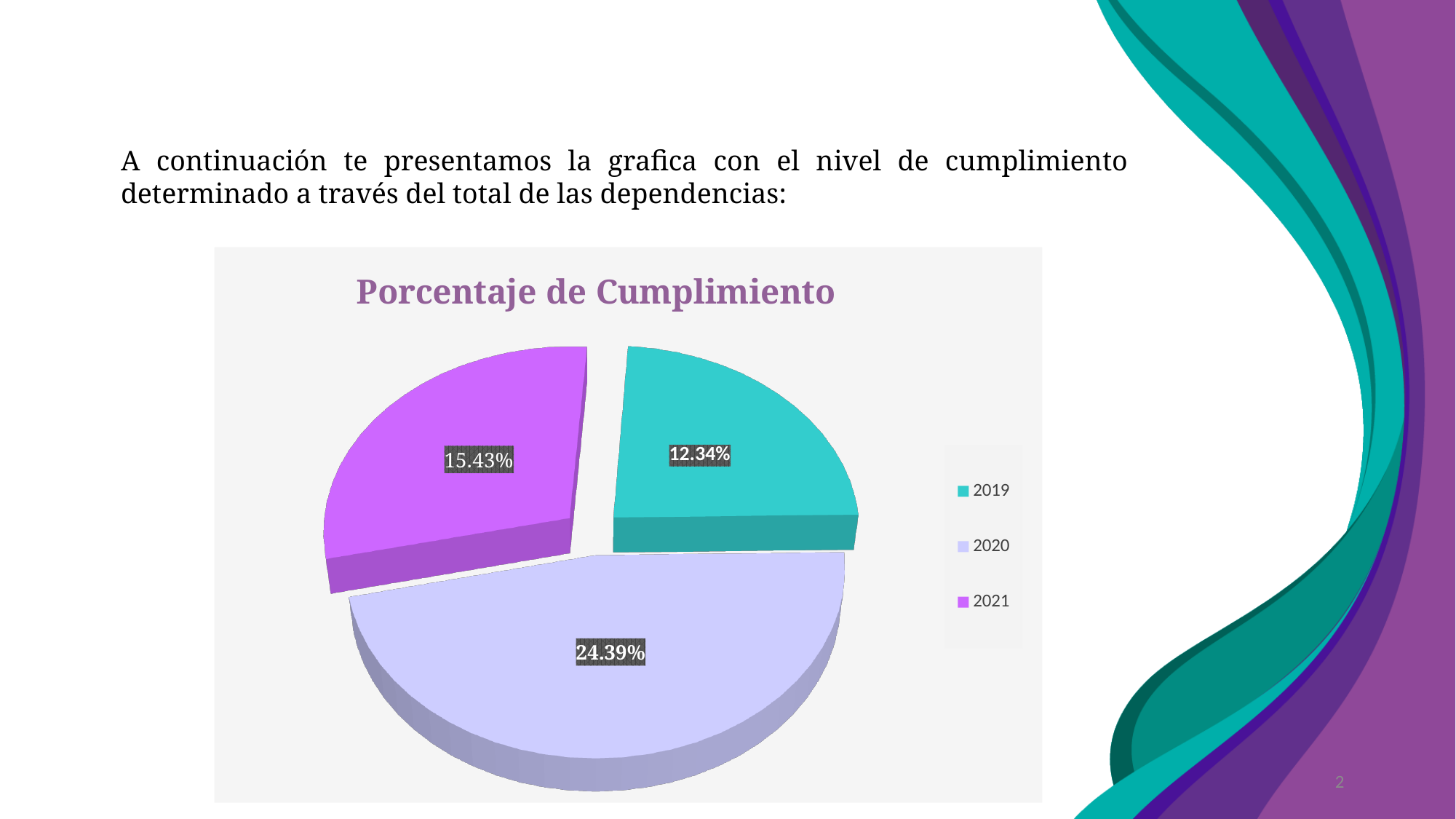
What is the value shown for 2019? 12.34% What is the value shown for 2021? 15.43% What is the value shown for 2020? 24.39% What is the difference between the values for 2021 and 2019? 3.09% What is the difference between the values for 2020 and 2019? 12.05% Which year has the largest slice of the pie? 2020 What is the title of the chart? Porcentaje de Cumplimiento How many slices does the pie chart have? 3 What type of chart is shown on the slide? Pie chart Which is larger, the value for 2021 or the value for 2019? 2021 How many entries does the legend list? 3 Which year has the smallest slice of the pie? 2019